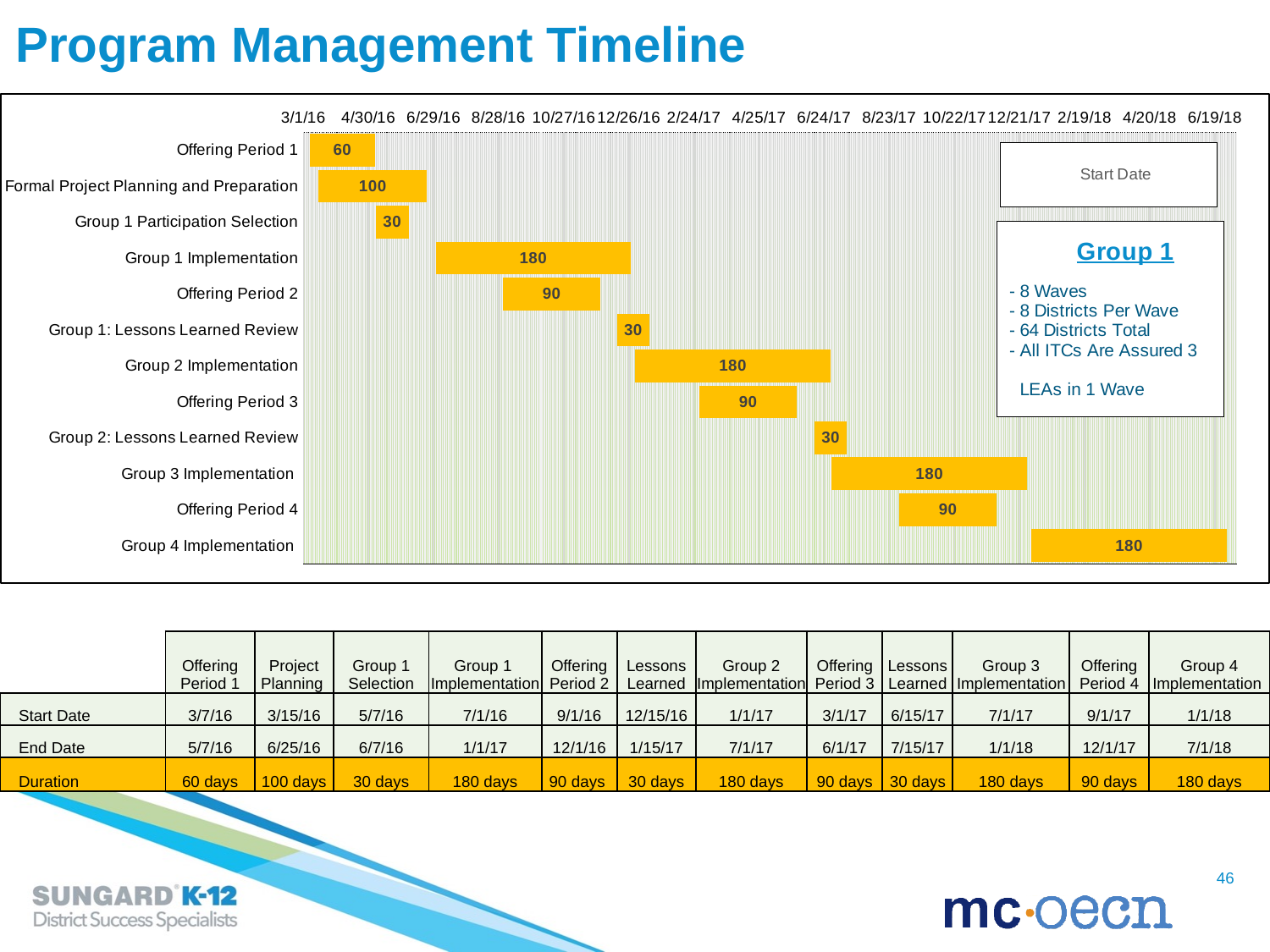
How many categories (rows) are plotted in the chart? 12 What is the difference between the values for Group 3 Implementation and Offering Period 4? 90 What is the title of the slide containing the chart? Program Management Timeline What is the value labelled on the Group 1 Implementation bar? 180 What is the data label on the bar for Offering Period 1? 60 What is the difference between the values for Formal Project Planning and Preparation and Offering Period 1? 40 What value is shown on the bar for Formal Project Planning and Preparation? 100 What kind of chart is shown on the slide? Bar chart What is the data label on the Group 2: Lessons Learned Review bar? 30 What value is printed on the bar for Offering Period 3? 90 Which bar is longer, Offering Period 2 or Group 1 Participation Selection? Offering Period 2 Which bar is longer, Offering Period 1 or Formal Project Planning and Preparation? Formal Project Planning and Preparation